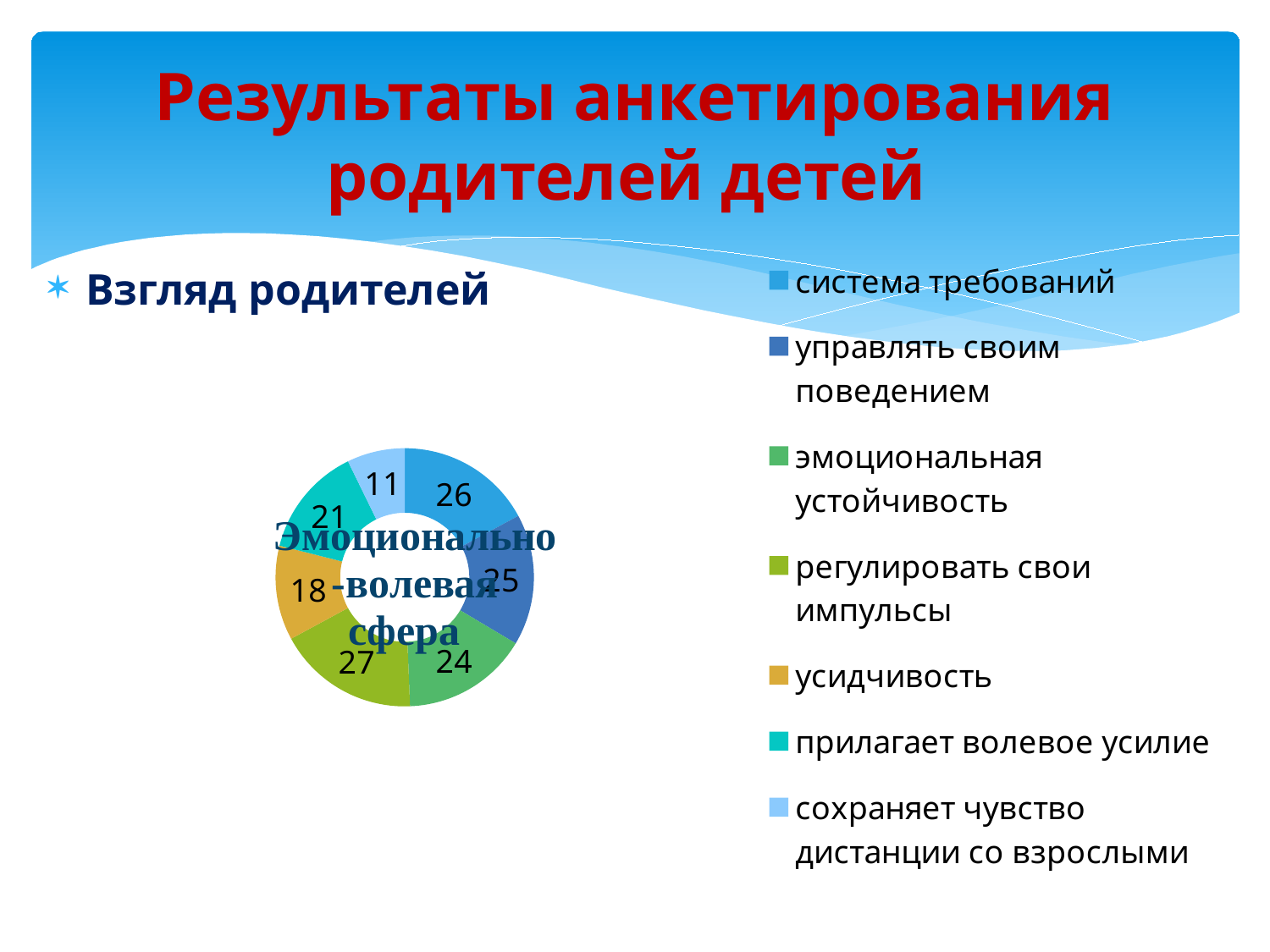
What is the value for "система требований"? 26 What is the value for "прилагает волевое усилие"? 21 Which category has the lowest value? сохраняет чувство дистанции со взрослыми What is the difference between the values for "регулировать свои импульсы" and "усидчивость"? 9 Which category has the highest value? регулировать свои импульсы How many categories does the chart show? 7 What is the value for "эмоциональная устойчивость"? 24 Which is larger, the value for "управлять своим поведением" or the value for "прилагает волевое усилие"? управлять своим поведением What is the value for "усидчивость"? 18 What is the total of all values in the chart? 152 What is the title of the chart? Эмоционально-волевая сфера What kind of chart is shown on the slide? doughnut chart